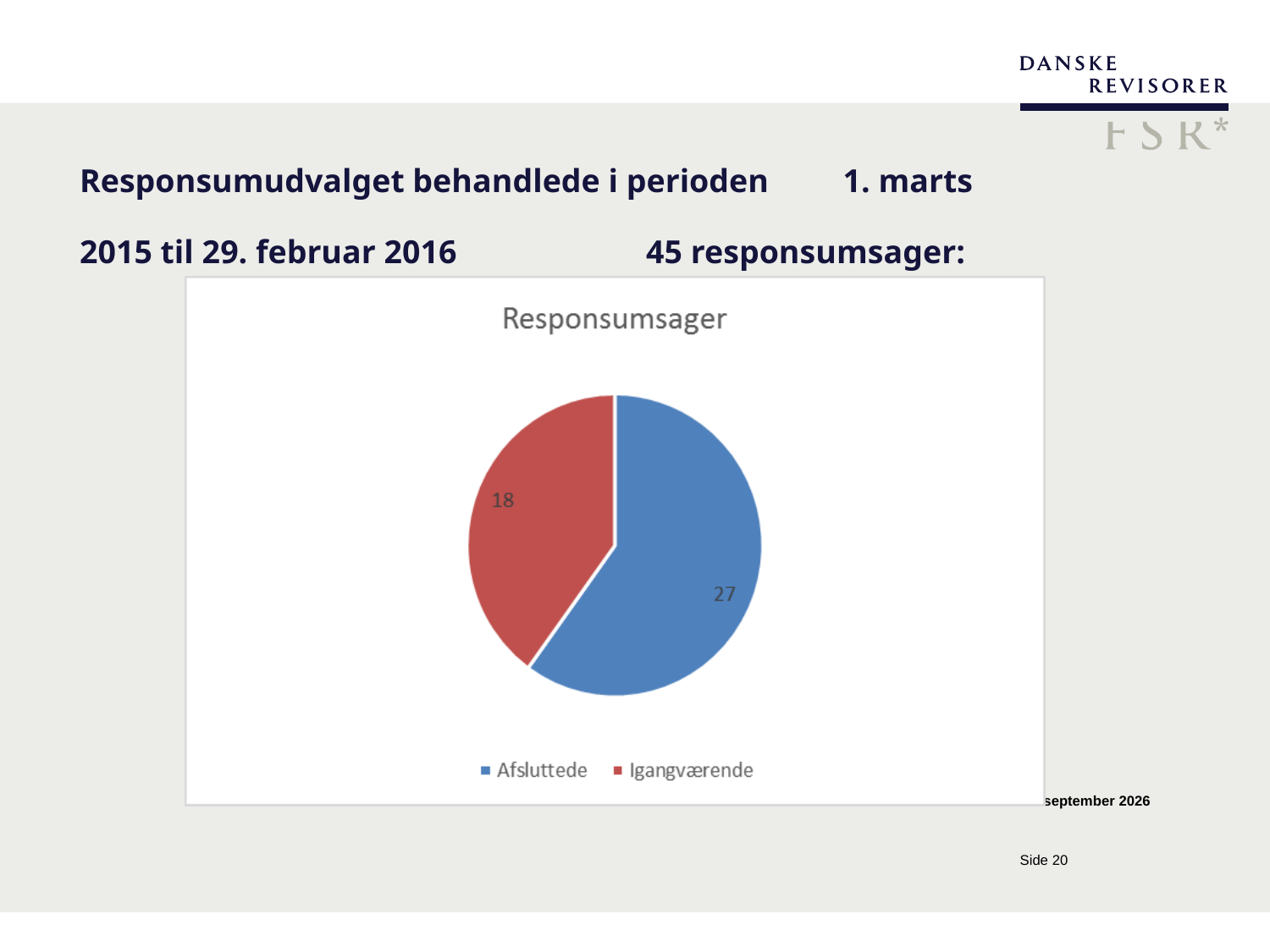
What is the difference between the values for Afsluttede and Igangværende? 9 What is the value for Afsluttede? 27 What is the value for Igangværende? 18 What is the total of all slices in the pie chart? 45 What share of the pie does Afsluttede represent? 60% Which is larger, Afsluttede or Igangværende? Afsluttede What type of chart is shown on the slide? pie chart Which category has the largest slice? Afsluttede How many entries does the legend list? 2 Which category has the smallest slice? Igangværende How many slices does the pie chart have? 2 What is the title of the chart? Responsumsager